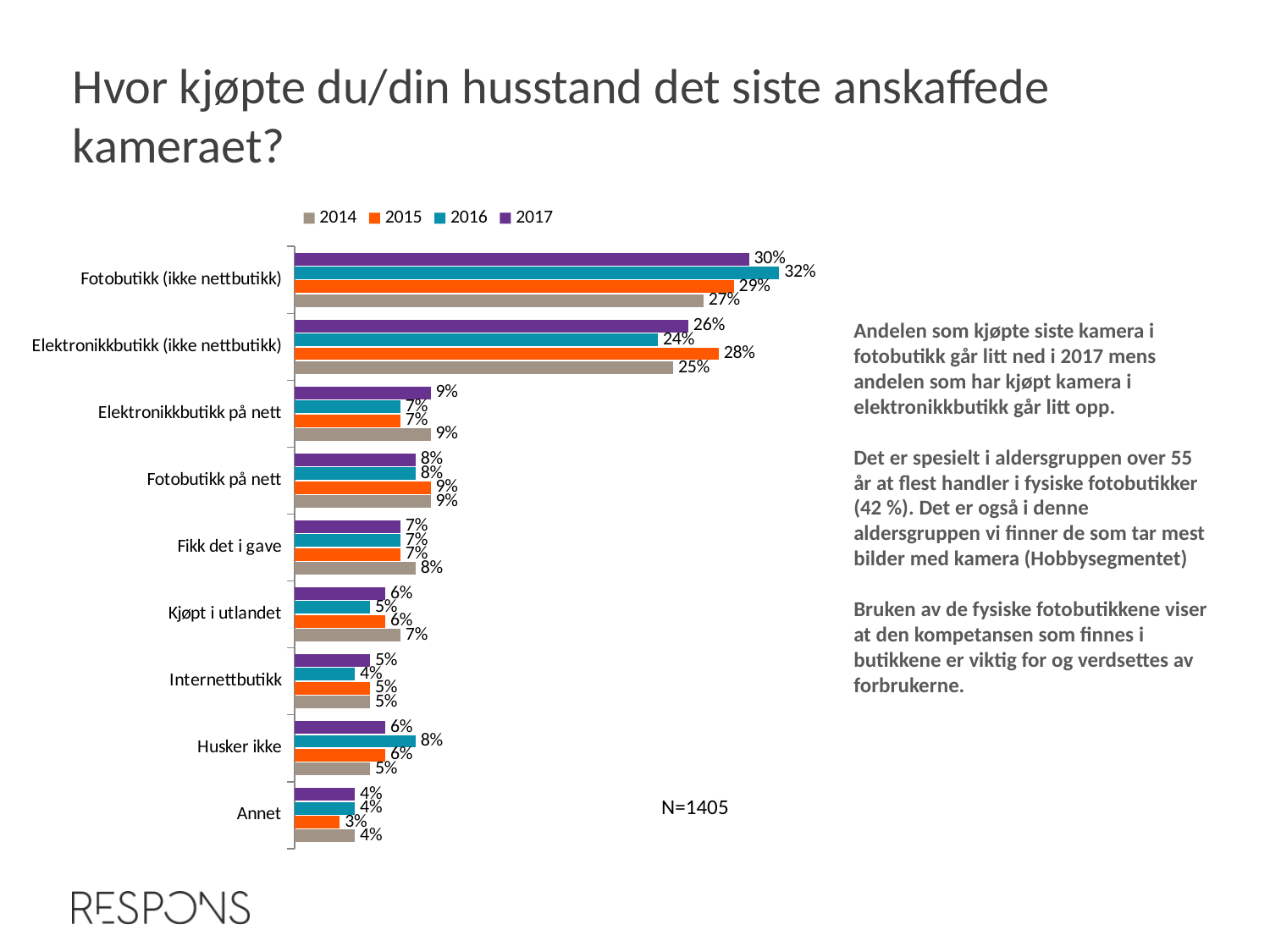
What is the 2017 value for Fotobutikk (ikke nettbutikk)? 30% How many categories are shown on the chart? 9 What is the difference between the 2016 and 2017 values for Fotobutikk (ikke nettbutikk)? 2% Which is larger for Elektronikkbutikk (ikke nettbutikk): the 2017 value or the 2016 value? 2017 Which category has the lowest 2015 value? Annet Which year is shown in orange in the legend? 2015 What kind of chart is shown on the slide? Bar chart What is the 2015 value for Elektronikkbutikk (ikke nettbutikk)? 28% What is the 2016 value for Fotobutikk (ikke nettbutikk)? 32% What is the 2014 value for Husker ikke? 5% Which category has the highest 2017 value? Fotobutikk (ikke nettbutikk) How many series does the legend list? 4